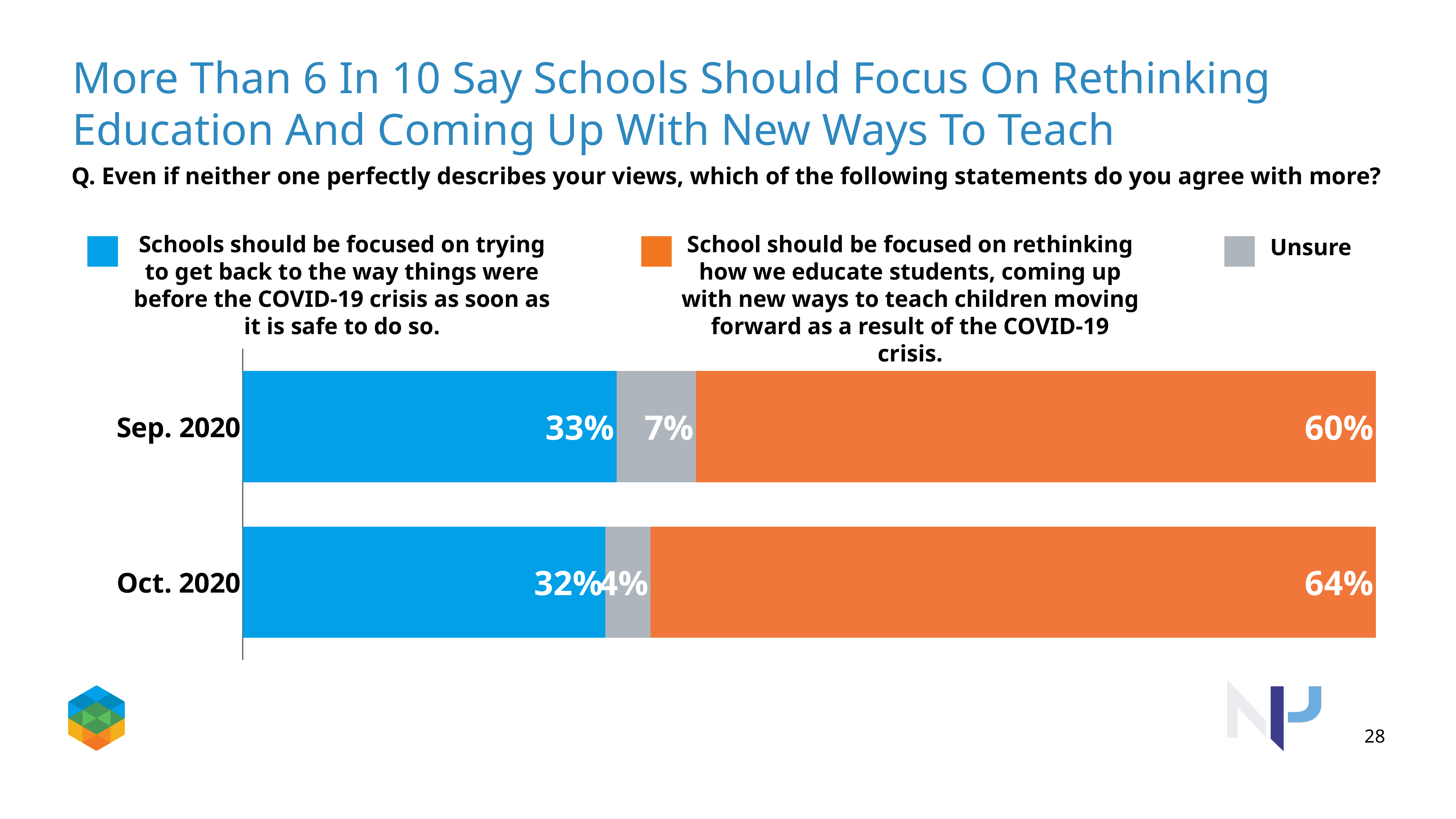
What percentage said schools should be focused on getting back to the way things were in Sep. 2020? 33% How many series does the legend list? 3 Which period had the higher share saying schools should focus on rethinking how we educate students, Sep. 2020 or Oct. 2020? Oct. 2020 How many time periods are shown in the chart? 2 What percentage were unsure in Oct. 2020? 4% What percentage were unsure in Sep. 2020? 7% What kind of chart is shown on the slide? Stacked bar chart What is the difference between the unsure share in Sep. 2020 and Oct. 2020? 3 percentage points Which colour represents the 'Unsure' response in the chart? Gray What percentage said schools should be focused on rethinking how we educate students in Oct. 2020? 64% What is the total of the Oct. 2020 bar? 100% By how many percentage points did the share saying schools should focus on rethinking education change from Sep. 2020 to Oct. 2020? 4 percentage points